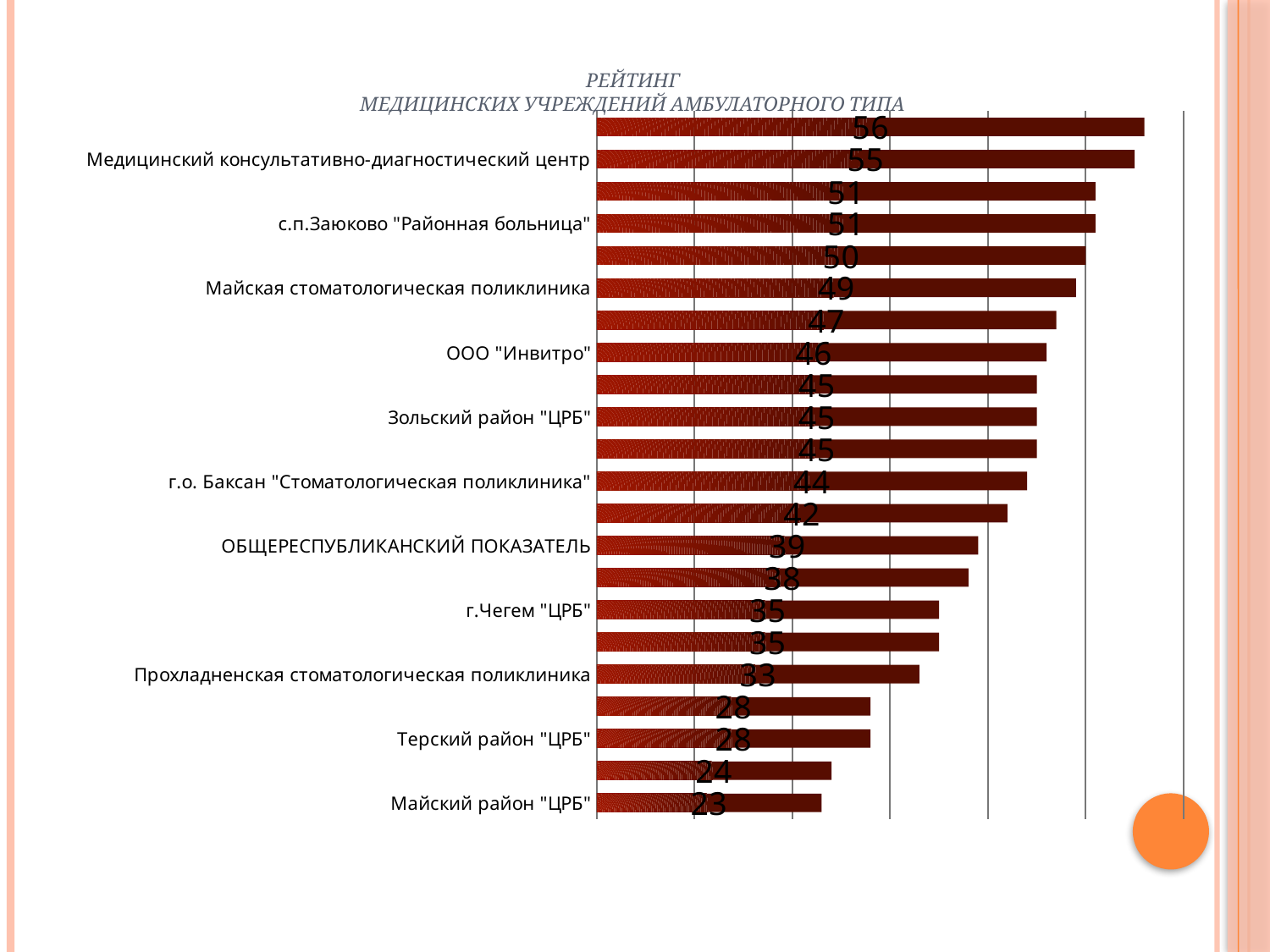
What is the value for Медицинский консультативно-диагностический центр? 55 What is the value for ОБЩЕРЕСПУБЛИКАНСКИЙ ПОКАЗАТЕЛЬ? 39 What kind of chart is shown on the slide? Bar chart What is the title of the chart? РЕЙТИНГ МЕДИЦИНСКИХ УЧРЕЖДЕНИЙ АМБУЛАТОРНОГО ТИПА Which labelled category has the lowest value? Майский район "ЦРБ" What is the difference between the values for Медицинский консультативно-диагностический центр and Майский район "ЦРБ"? 32 What is the value for Терский район "ЦРБ"? 28 What is the value for с.п.Заюково "Районная больница"? 51 Which has a larger value, г.Чегем "ЦРБ" or Прохладненская стоматологическая поликлиника? г.Чегем "ЦРБ" What is the value for ООО "Инвитро"? 46 What is the value for Майский район "ЦРБ"? 23 How many bars are plotted in the chart? 22